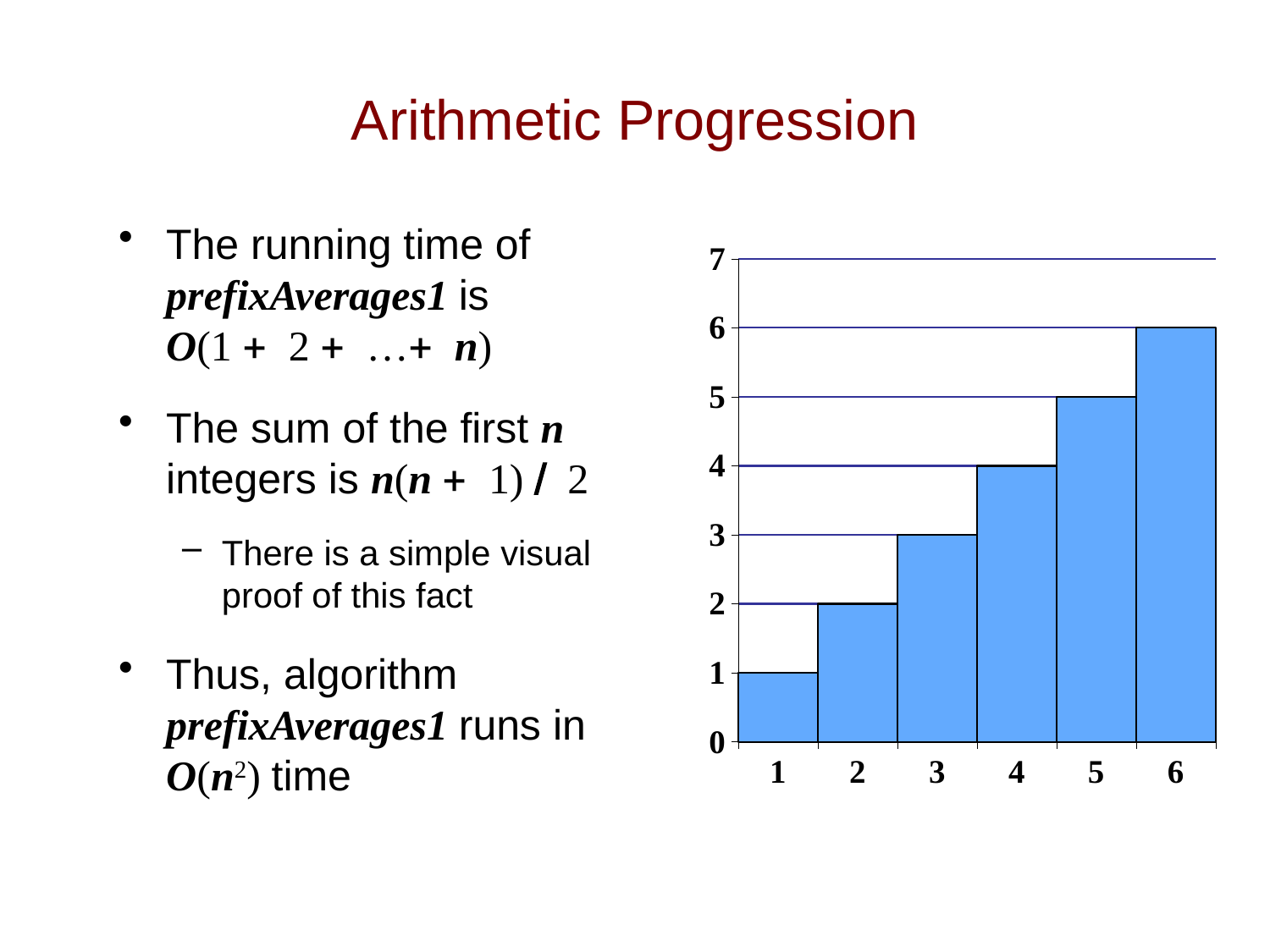
What is the highest value labelled on the vertical axis? 7 What is the value of the bar for category 3? 3 Do the bar values rise or fall from category 1 to category 6? rise Which category has the highest bar? 6 Which is larger, the bar for category 4 or the bar for category 2? category 4 How many bars does the chart have? 6 What colour are the bars in the chart? blue What is the difference between the values for category 5 and category 2? 3 What is the value of the bar for category 1? 1 Which category has the lowest bar? 1 What is the value of the bar for category 6? 6 What kind of chart is shown on the slide? bar chart